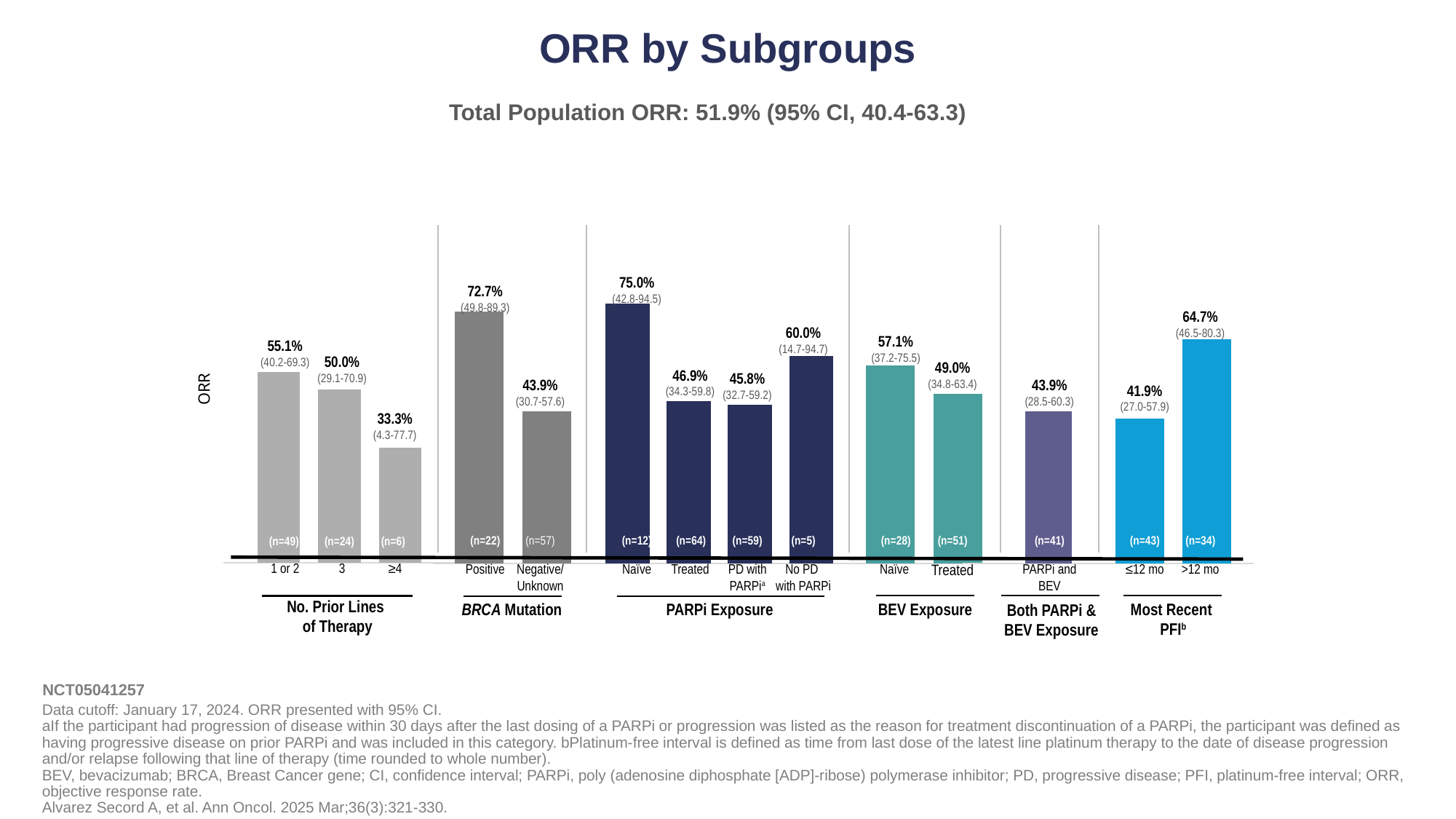
What is the ORR for the Both PARPi & BEV Exposure subgroup? 43.9% Which subgroup has the lowest ORR on the chart? ≥4 prior lines of therapy What is the ORR for the PARPi-naïve subgroup? 75.0% How many bars are plotted on the chart? 14 How many patients are in the No PD with PARPi subgroup? n=5 What type of chart is shown on the slide? Bar chart What is the ORR for patients with 1 or 2 prior lines of therapy? 55.1% What is the ORR for the BRCA mutation Positive subgroup? 72.7% What is the difference in ORR between the >12 mo and ≤12 mo Most Recent PFI subgroups? 22.8% What is the total population ORR stated on the slide? 51.9% Which has a higher ORR: BEV-naïve or BEV-treated patients? Naïve Which subgroup has the highest ORR on the chart? PARPi Exposure Naïve